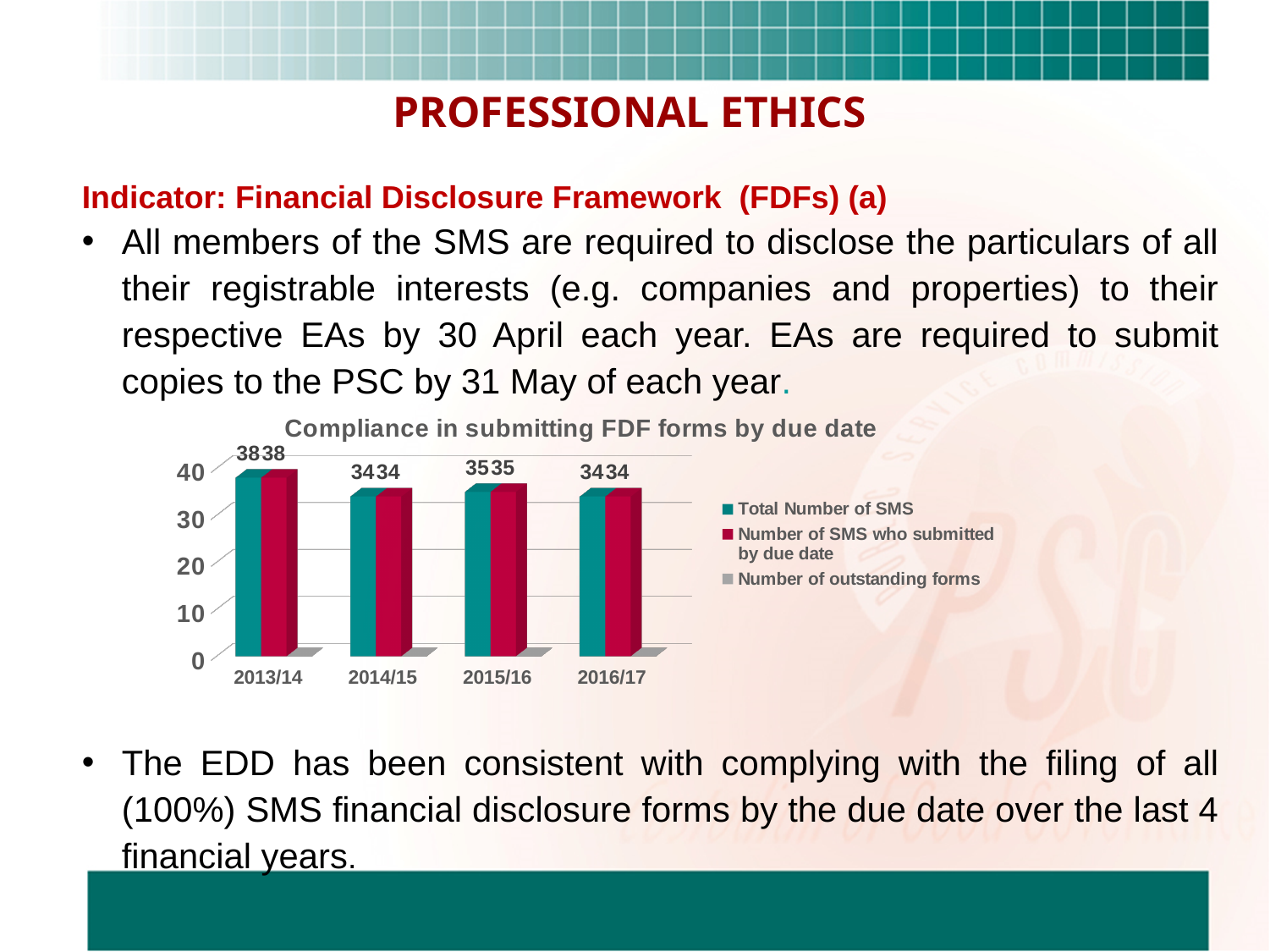
What is the Number of SMS who submitted by due date in 2015/16? 35 What kind of chart is shown on the slide? bar chart Is the Total Number of SMS for 2014/15 greater or less than 30? greater What is the Total Number of SMS for 2013/14? 38 What is the Total Number of SMS for 2016/17? 34 What is the title of the chart? Compliance in submitting FDF forms by due date Which legend entry is shown in red? Number of SMS who submitted by due date How many financial years are shown on the x axis of the chart? 4 Which financial year has the highest Total Number of SMS? 2013/14 How many series does the chart legend list? 3 What is the difference between the Total Number of SMS in 2013/14 and in 2014/15? 4 Is the Total Number of SMS in 2015/16 larger or smaller than in 2013/14? smaller